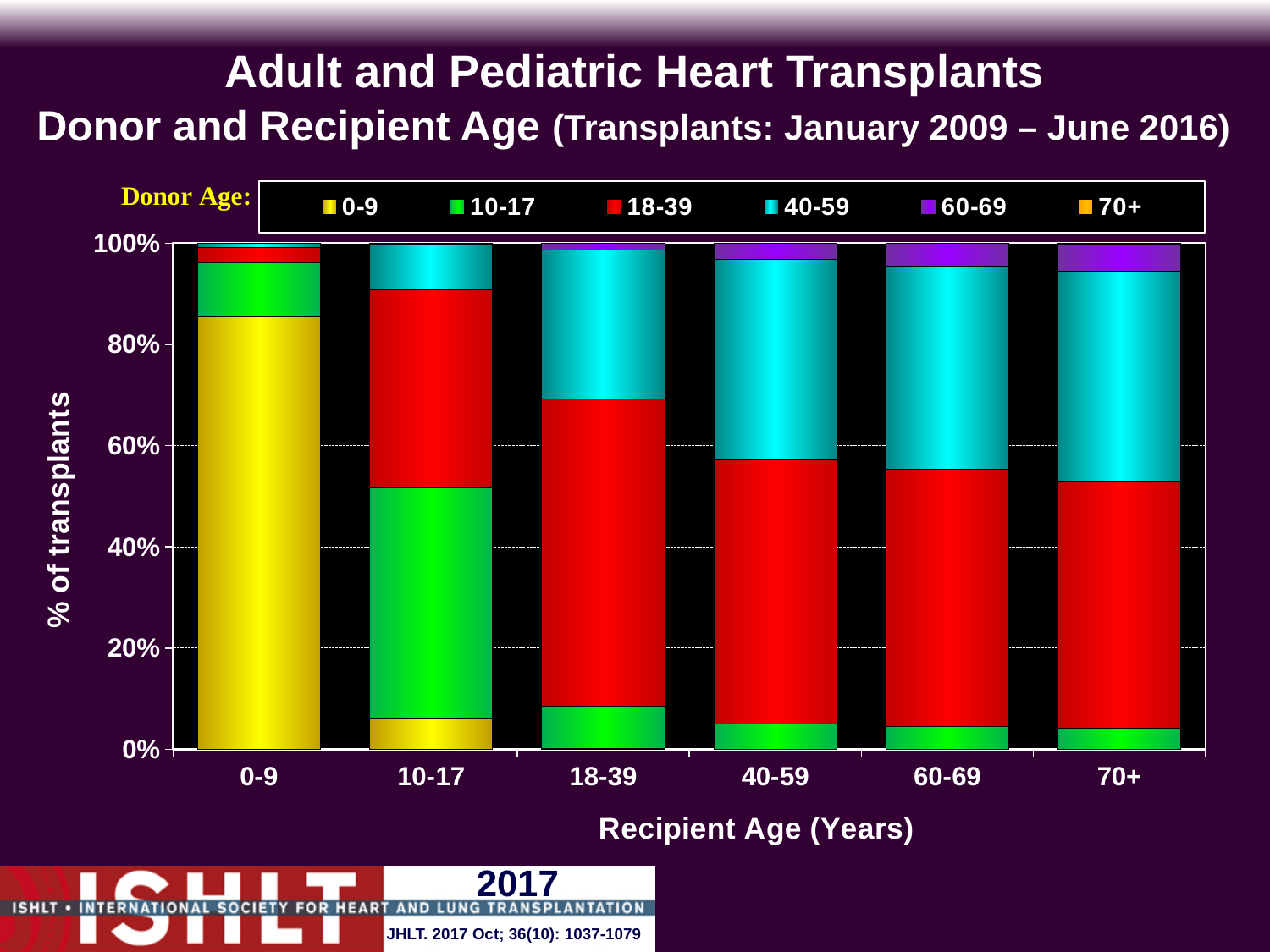
For recipients aged 0-9, is the share of donors aged 0-9 greater or less than 80%? greater For recipients aged 18-39, is the share of donors aged 40-59 greater or less than 40%? less For recipients aged 18-39, which donor age group has the larger share: 18-39 or 40-59? 18-39 Which recipient age group has the largest share of donors aged 0-9? 0-9 What is the label of the y axis? % of transplants How many donor age groups does the legend list? 6 For recipients aged 40-59, is the share of donors aged 18-39 greater or less than 40%? greater How many recipient age categories are shown on the x axis? 6 What kind of chart is shown on the slide? Stacked bar chart What is the label of the x axis? Recipient Age (Years) For recipients aged 0-9, which donor age group has the larger share: 0-9 or 10-17? 0-9